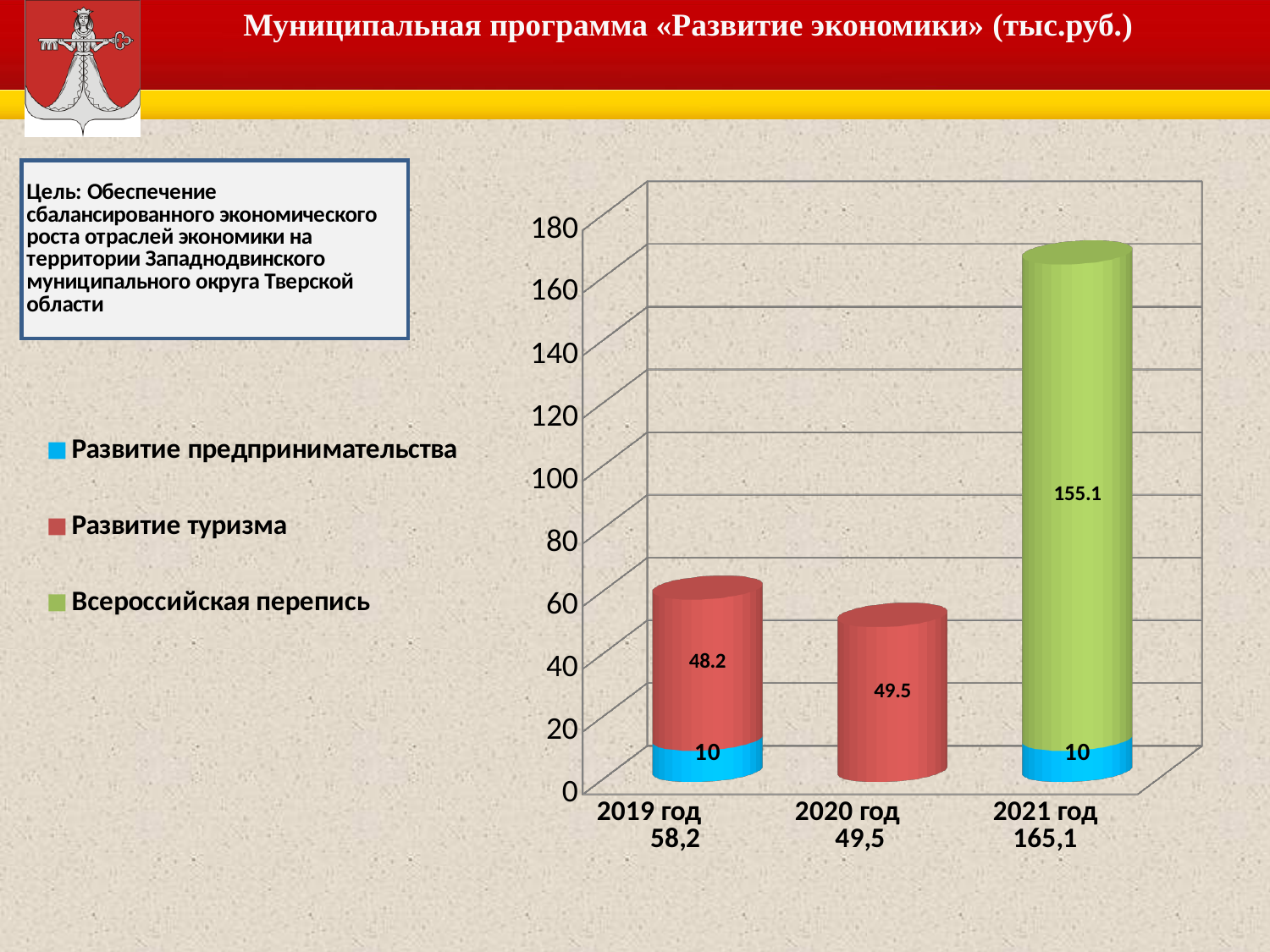
What is the value for Развитие туризма in 2019 год? 48.2 How many series does the legend list? 3 What is the difference between the Развитие туризма values for 2020 год and 2019 год? 1.3 What is the total of the stacked bar for 2021 год? 165,1 What is the value for Всероссийская перепись in 2021 год? 155.1 Which year has the highest total bar? 2021 год Which year has the lowest total bar? 2020 год What is the value for Развитие туризма in 2020 год? 49.5 Is the total bar for 2021 год greater or less than 160? greater What is the value for Развитие предпринимательства in 2019 год? 10 How many years are shown on the x axis? 3 Which is larger: the Развитие туризма value in 2019 год or in 2020 год? 2020 год